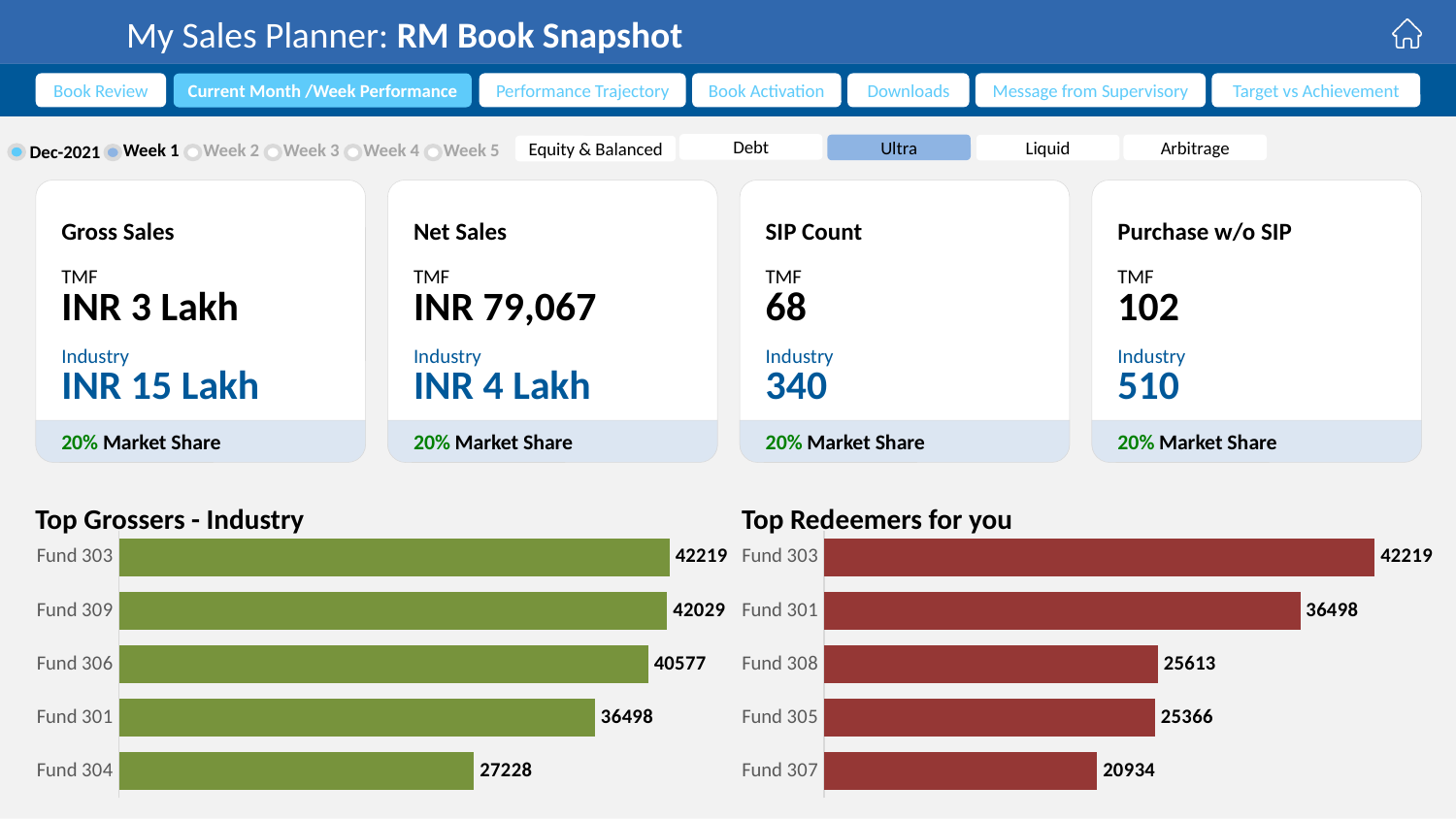
In the 'Top Grossers - Industry' chart, which fund has the highest value? Fund 303 In the 'Top Redeemers for you' chart, which is larger, the value for Fund 301 or the value for Fund 308? Fund 301 In the 'Top Grossers - Industry' chart, which fund has the lowest value? Fund 304 In the 'Top Redeemers for you' chart, which fund has the lowest value? Fund 307 In the 'Top Grossers - Industry' chart, what is the value for Fund 306? 40577 In the 'Top Grossers - Industry' chart, how many funds are shown? 5 In the 'Top Redeemers for you' chart, what is the value for Fund 308? 25613 In the 'Top Redeemers for you' chart, what is the difference between the values for Fund 303 and Fund 301? 5721 In the 'Top Grossers - Industry' chart, what is the value for Fund 304? 27228 In the 'Top Grossers - Industry' chart, what is the difference between the values for Fund 303 and Fund 309? 190 What type of chart is 'Top Redeemers for you'? Bar chart In the 'Top Redeemers for you' chart, what is the value for Fund 307? 20934